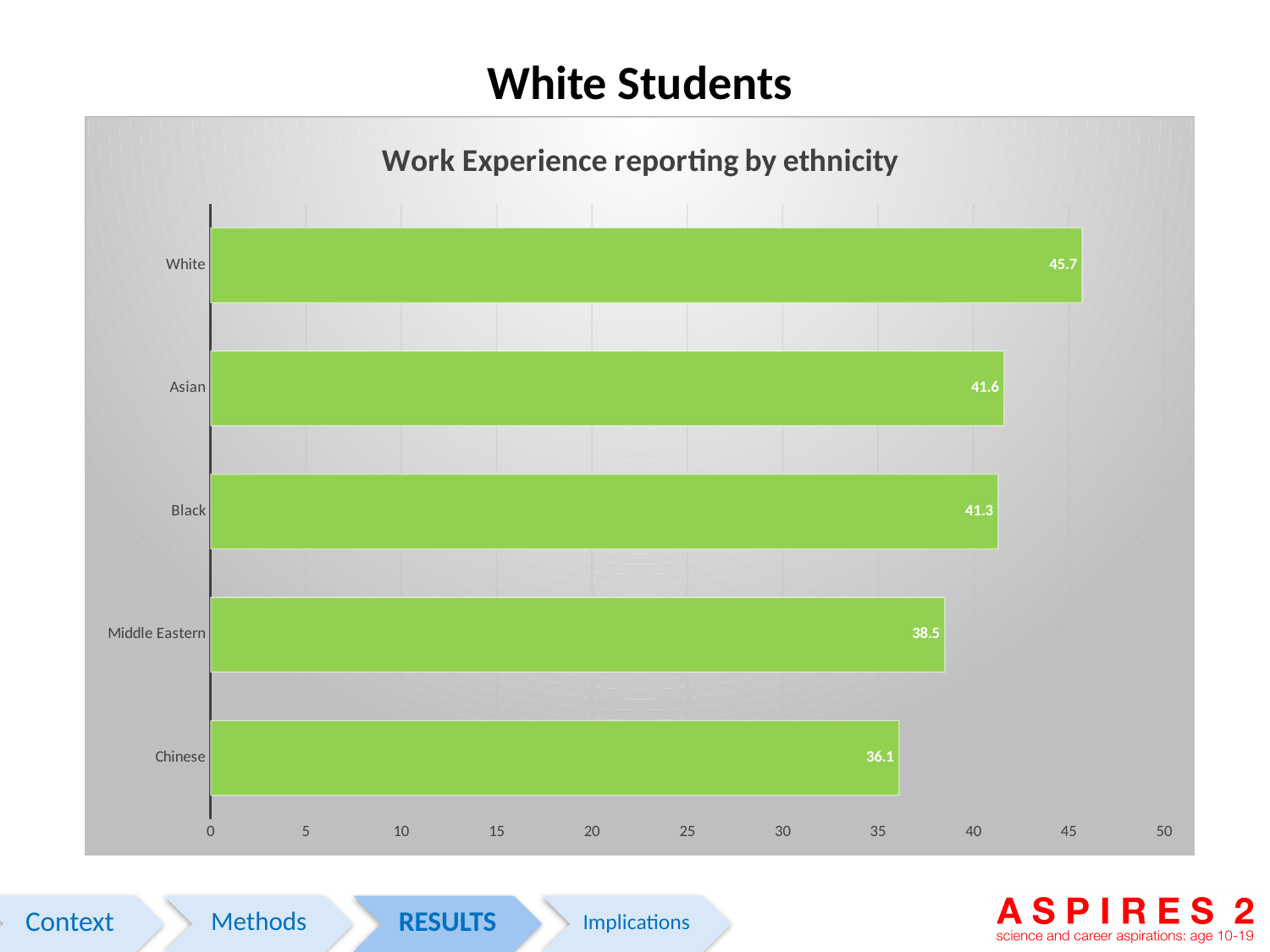
What is the value for Middle Eastern? 38.5 Which ethnicity has the lowest value? Chinese What is the value for Chinese? 36.1 Which is larger, the value for Asian or the value for Middle Eastern? Asian What is the value for White in the Work Experience reporting by ethnicity chart? 45.7 Which ethnicity has the highest value? White How many ethnicity categories are shown in the chart? 5 What is the difference between the values for White and Chinese? 9.6 What is the difference between the values for Asian and Black? 0.3 What kind of chart is shown on the slide? bar chart What is the title of the chart? Work Experience reporting by ethnicity Is the value for Black greater or less than 40? greater